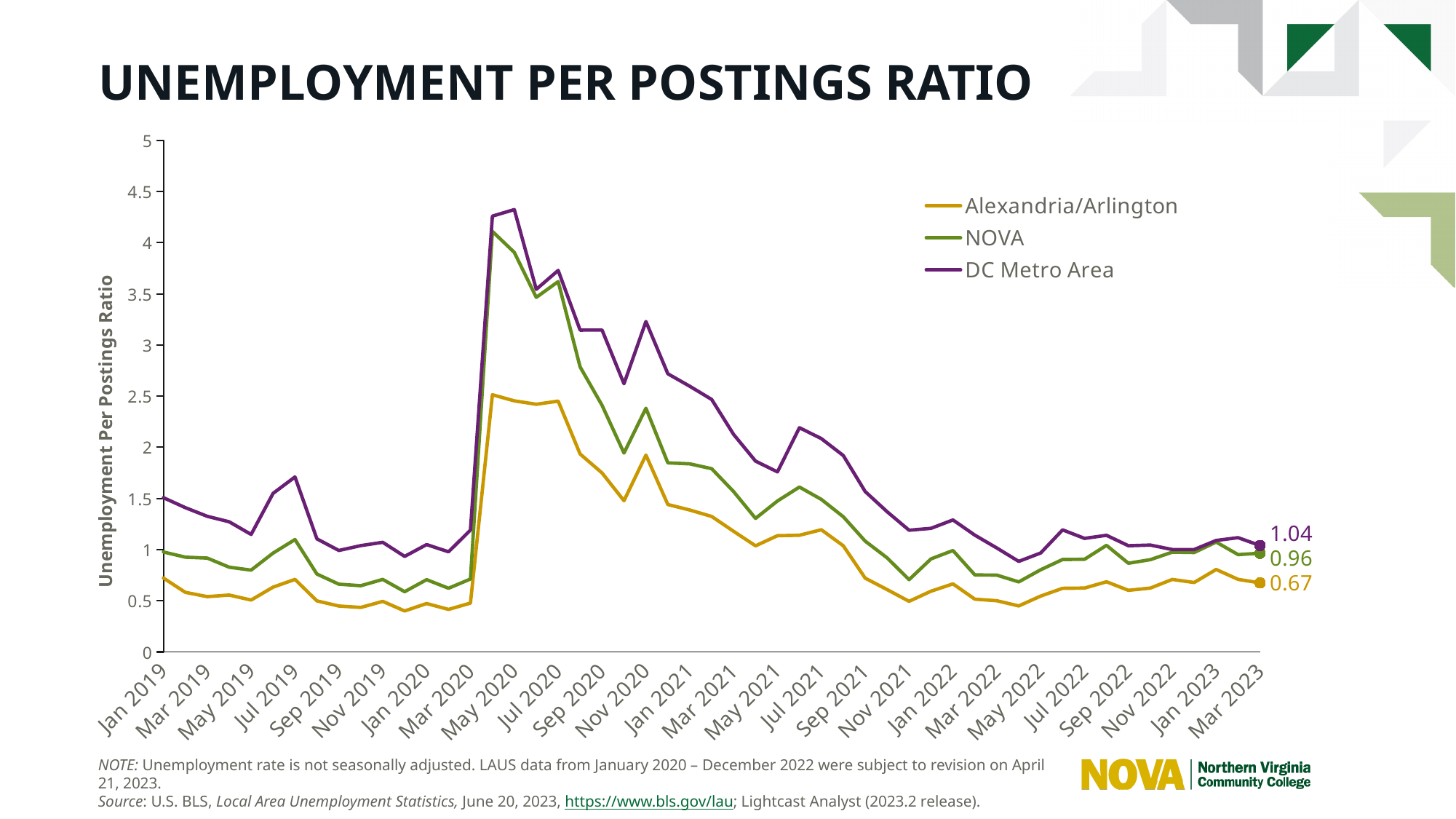
Is the value for Alexandria/Arlington in May 2020 greater or less than 2? greater What is the value for Alexandria/Arlington in Mar 2023? 0.67 What is the value for NOVA in Mar 2023? 0.96 Is the value for DC Metro Area in May 2020 greater or less than 4? greater What is the title of the vertical axis? Unemployment Per Postings Ratio In Mar 2023, what is the difference between the DC Metro Area value and the Alexandria/Arlington value? 0.37 Which series has the highest value in Mar 2023? DC Metro Area What kind of chart is shown on the slide? Line chart What is the value for DC Metro Area in Mar 2023? 1.04 In Mar 2023, which is larger: the NOVA value or the Alexandria/Arlington value? NOVA How many series does the legend list? 3 In Mar 2023, what is the difference between the NOVA value and the Alexandria/Arlington value? 0.29